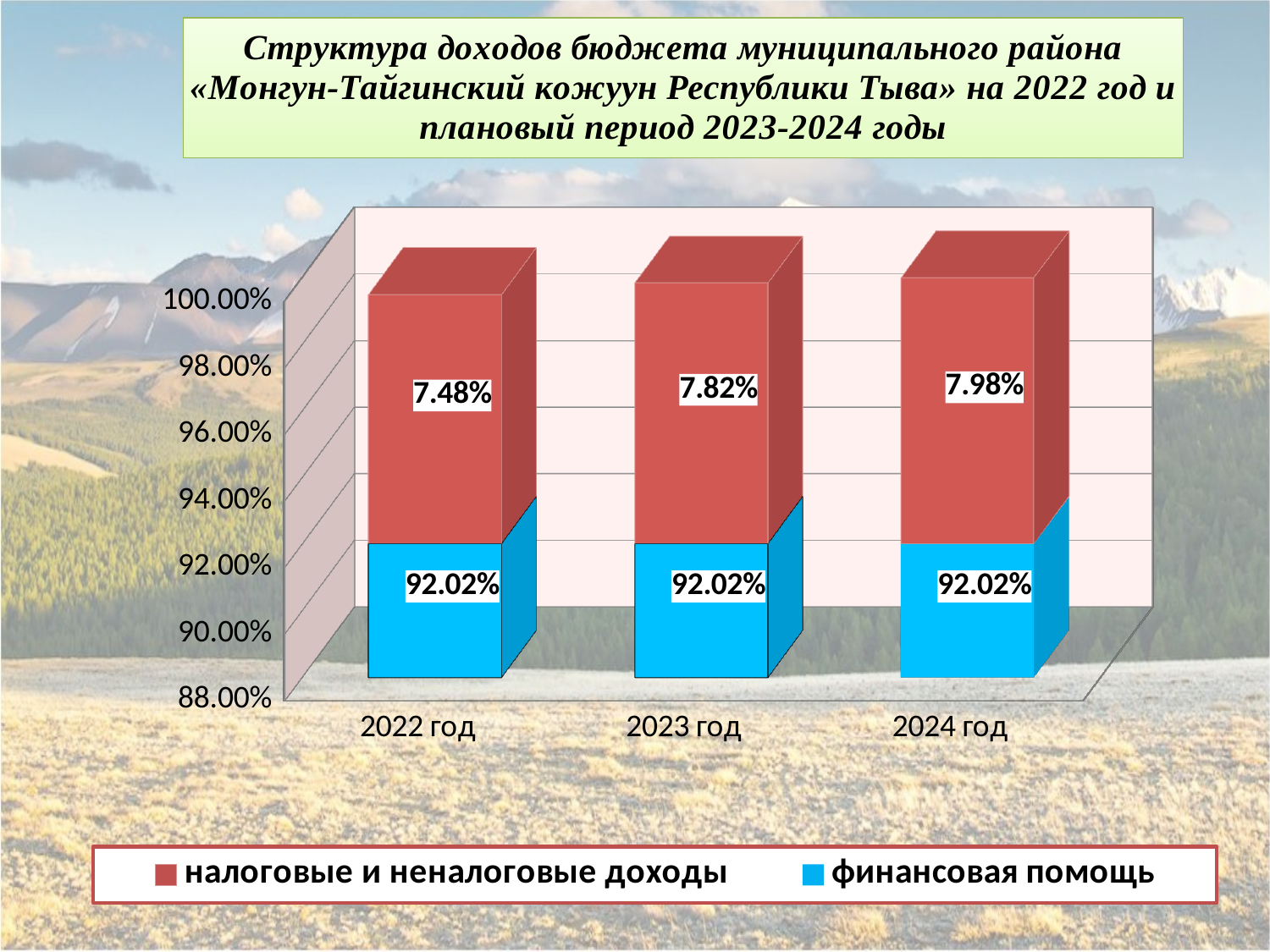
Do the values for налоговые и неналоговые доходы rise or fall from 2022 год to 2024 год? Rise How many years are shown on the x axis? 3 Which year has the lowest value for налоговые и неналоговые доходы? 2022 год What is the value for налоговые и неналоговые доходы in 2024 год? 7.98% Which series is shown in blue in the legend? финансовая помощь Which is larger: the налоговые и неналоговые доходы value for 2023 год or for 2022 год? 2023 год What is the difference between the налоговые и неналоговые доходы values for 2024 год and 2022 год? 0.50% What kind of chart is shown on the slide? Stacked bar chart How many series does the legend list? 2 What is the value for налоговые и неналоговые доходы in 2022 год? 7.48% What is the value for финансовая помощь in 2023 год? 92.02% Which year has the highest value for налоговые и неналоговые доходы? 2024 год